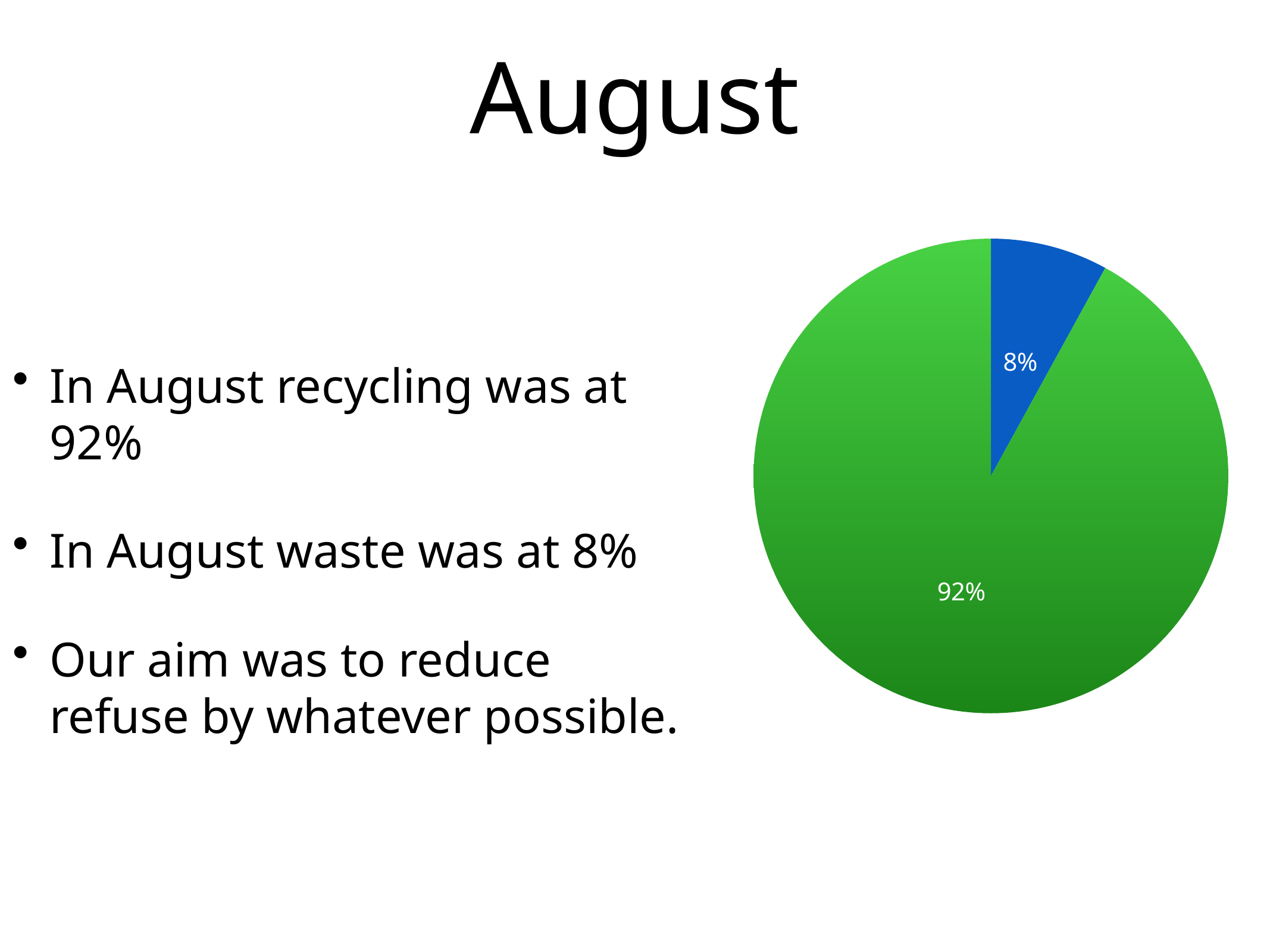
What colour is the slice labelled 92% in the pie chart? green Which slice of the pie chart is the largest? the green slice (92%) What is the difference between the two slice values in the pie chart? 84% Which slice of the pie chart is the smallest? the blue slice (8%) What is the title of the slide containing the pie chart? August What percentage is shown on the green slice of the pie chart? 92% What share of the pie does the smaller slice represent? 8% What kind of chart is shown on the slide? pie chart How many slices does the pie chart have? 2 What is the total of the two slice values shown in the pie chart? 100% Is the green slice or the blue slice larger in the pie chart? the green slice What percentage is shown on the blue slice of the pie chart? 8%